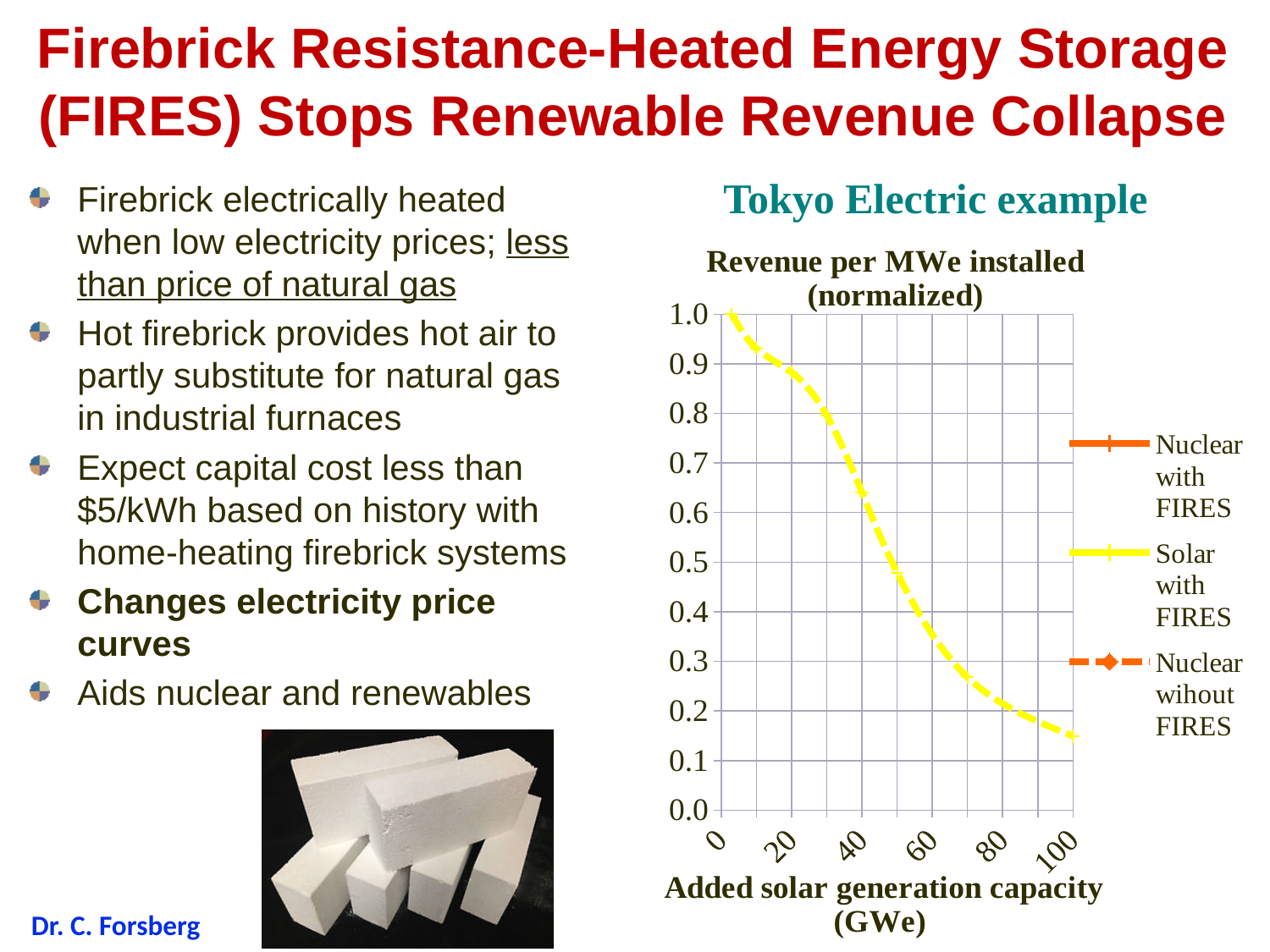
Is the Solar with FIRES value at 20 GWe greater or less than 0.8? greater What is the normalized revenue for Solar with FIRES at 0 GWe of added solar generation capacity? 1.0 Which is larger for Solar with FIRES: the value at 20 GWe or the value at 80 GWe? 20 GWe How many series does the chart legend list? 3 Is the Solar with FIRES value at 40 GWe greater or less than 0.6? greater What kind of chart is shown on the slide? line chart Does the Solar with FIRES line rise or fall as added solar generation capacity increases? fall What is the title of the chart? Revenue per MWe installed (normalized) Is the Solar with FIRES value at 80 GWe greater or less than 0.3? less What is the label of the x axis of the chart? Added solar generation capacity (GWe)